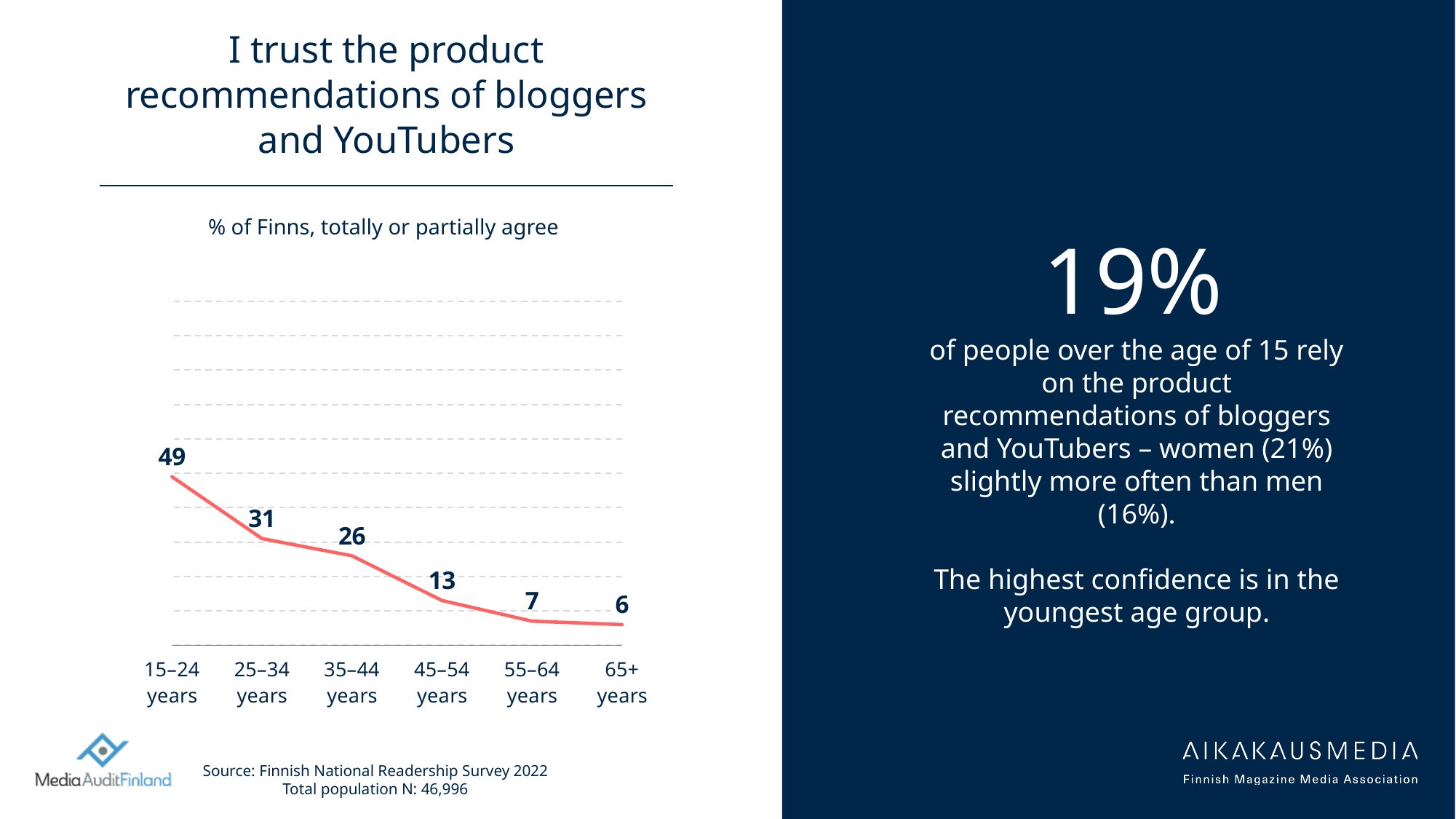
What kind of chart is shown on the slide? Line chart What is the value for the 15–24 years age group? 49 What is the difference between the values for 15–24 years and 25–34 years? 18 What is the title of the chart? I trust the product recommendations of bloggers and YouTubers What is the difference between the values for 35–44 years and 45–54 years? 13 How many age groups are plotted on the chart? 6 Do the values rise or fall as age increases along the x axis? Fall Which age group has the highest value? 15–24 years What is the value for the 35–44 years age group? 26 What is the value for the 65+ years age group? 6 Which age group has the lowest value? 65+ years Which is larger, the value for 25–34 years or the value for 45–54 years? 25–34 years